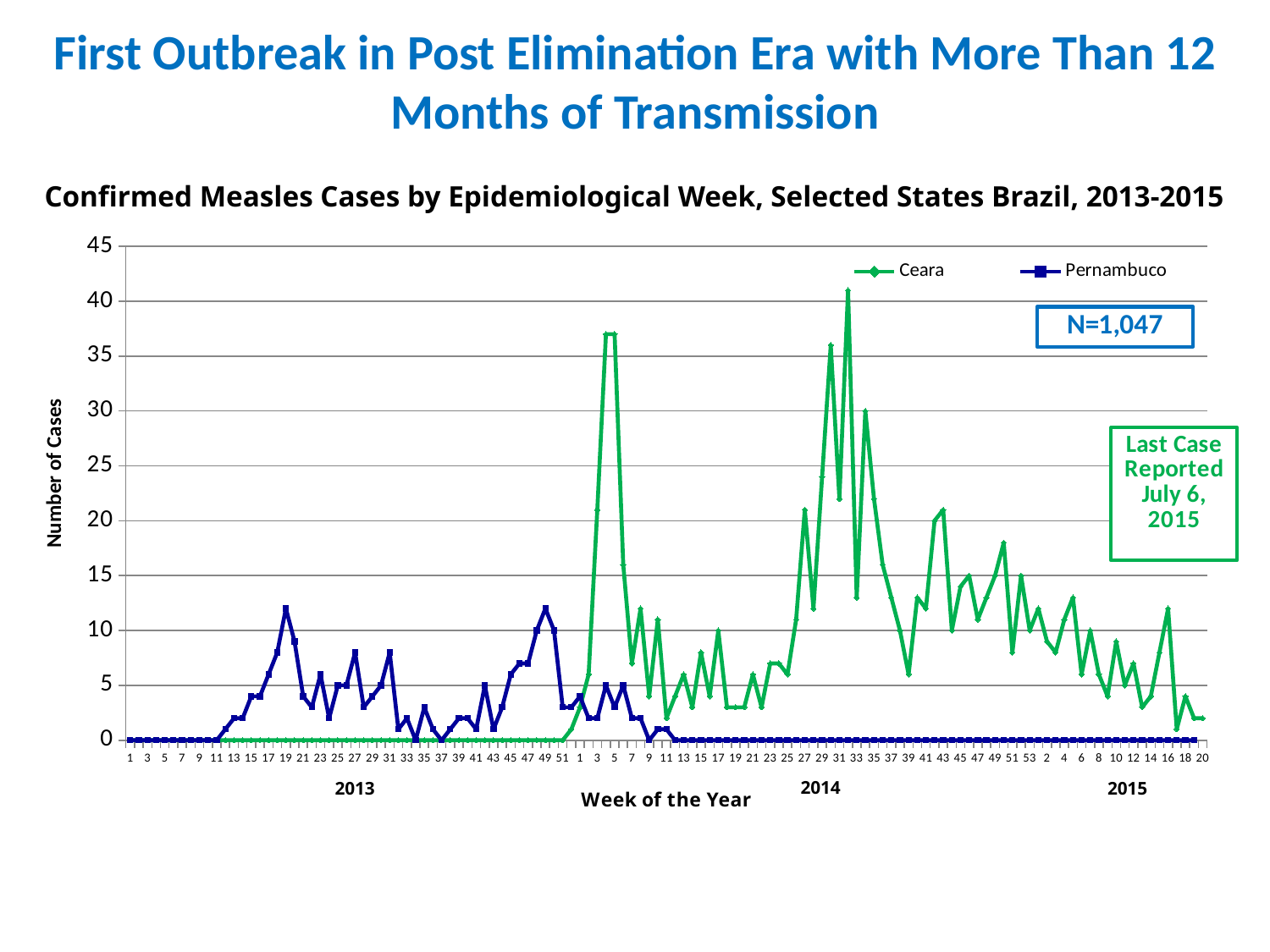
How many series does the legend list? 2 Is the highest value reached by the Pernambuco series greater or less than 15? less What total N is shown in the box on the chart? N=1,047 Is the Pernambuco value at week 10 of 2015 greater or less than 5? less Which series reaches the higher peak number of cases, Ceara or Pernambuco? Ceara What date is given for the last case reported? July 6, 2015 Is the highest value reached by the Ceara series greater or less than 35? greater Does the Ceara series generally rise or fall from week 33 of 2014 to week 20 of 2015? fall In which year does the Ceara series reach its highest value? 2014 Which series shows cases during the first half of 2013? Pernambuco What kind of chart is shown on the slide? line chart